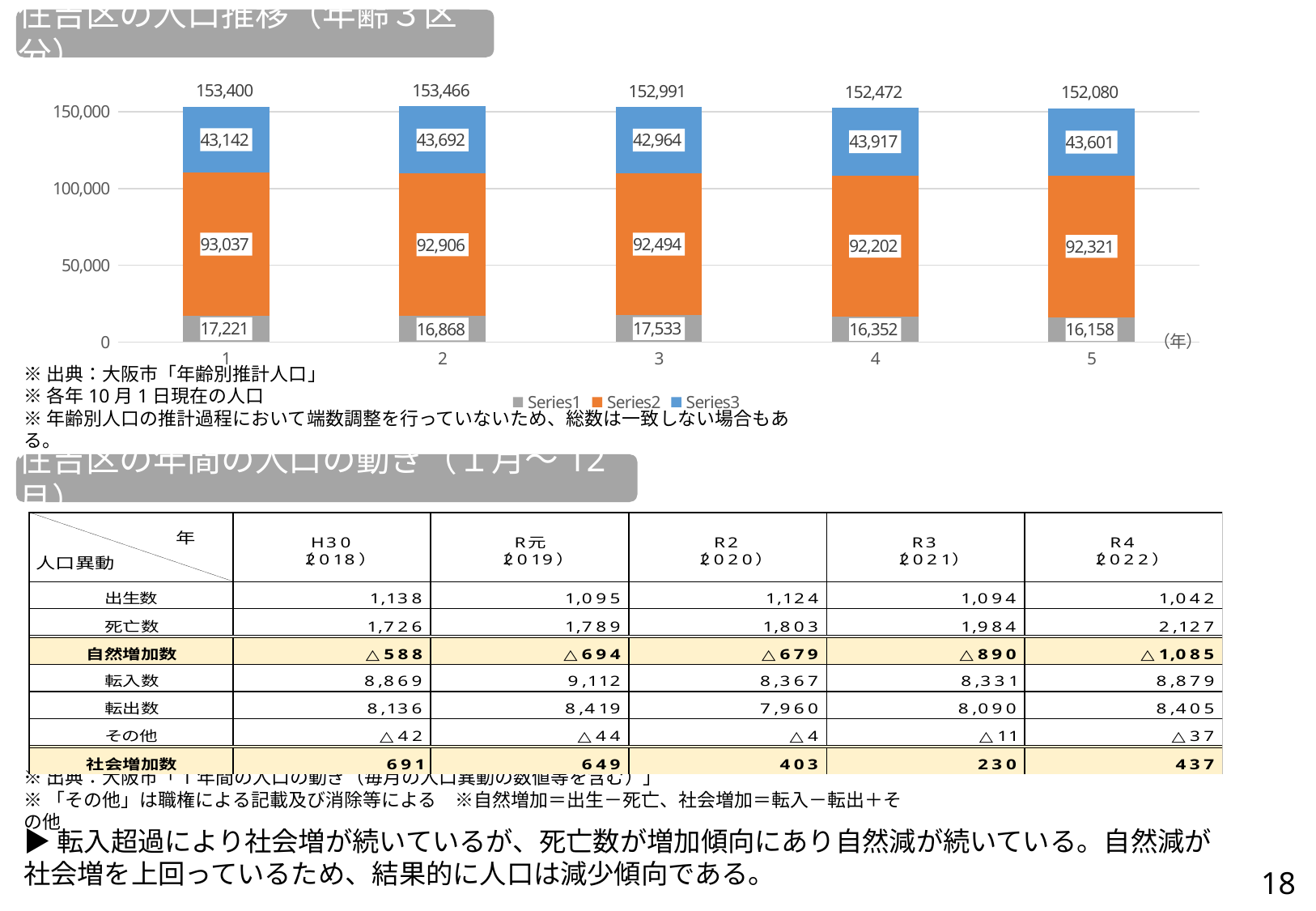
How many series does the chart legend list? 3 Which is larger, the Series1 value for category 1 or for category 2? category 1 Which category has the highest value for Series1? 3 How many categories are shown on the x axis of the chart? 5 Which category has the lowest value for Series2? 4 What is the total of the stacked bar for category 4? 152,472 Do the bar totals rise or fall from category 2 to category 5? fall What is the value of Series3 for category 2? 43,692 What is the value of Series2 for category 3? 92,494 What is the difference between the Series3 values for category 4 and category 3? 953 What is the value of Series1 for category 5? 16,158 What type of chart is shown on the slide? stacked bar chart